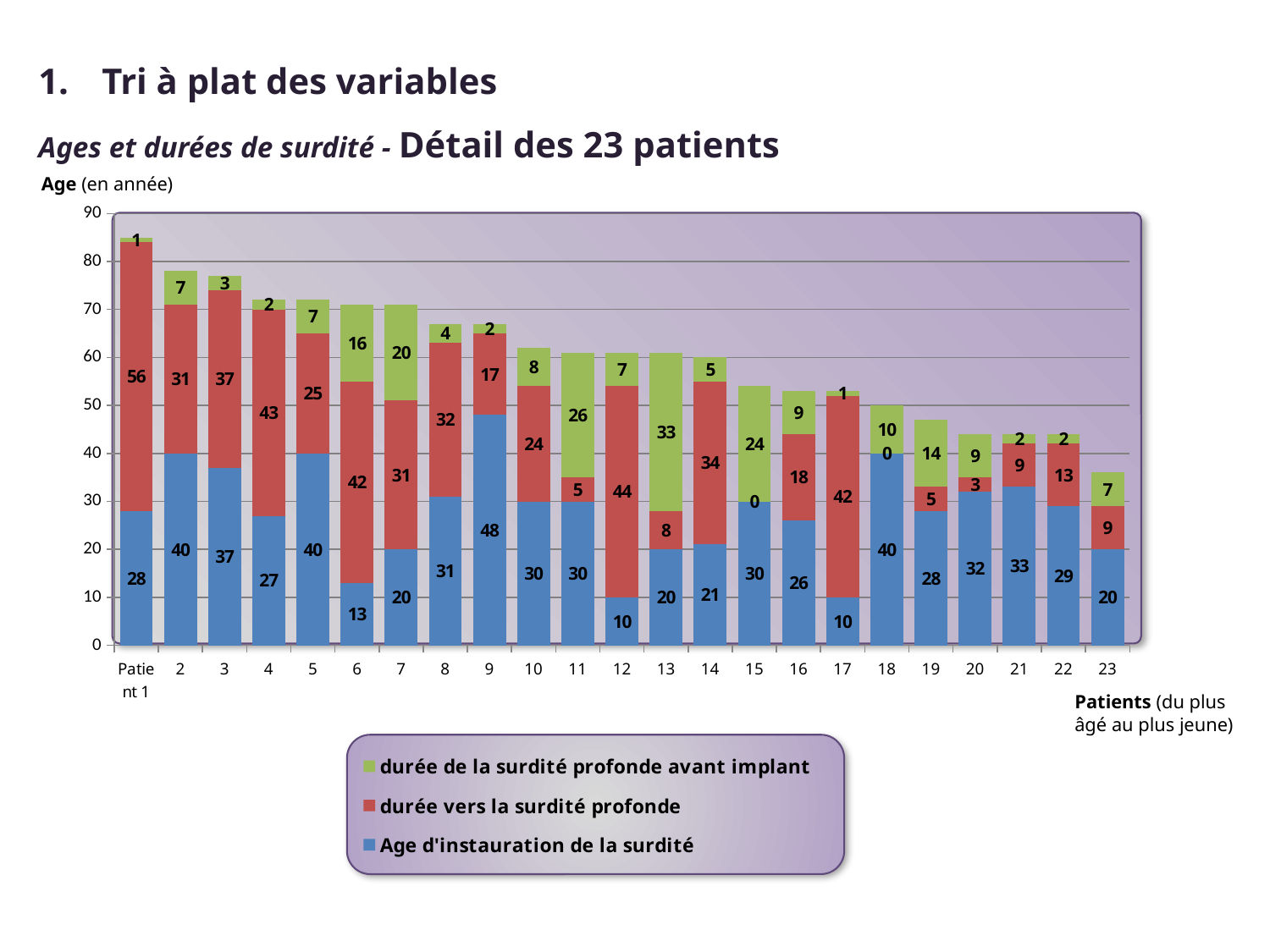
How many patients are shown on the x axis? 23 Which patient has the highest value for "Age d'instauration de la surdité"? 9 What is the value of "Age d'instauration de la surdité" for patient 9? 48 Which is larger: the "durée de la surdité profonde avant implant" for patient 6 or for patient 7? patient 7 How many series does the legend list? 3 What kind of chart is shown on the slide? stacked bar chart What is the total height of the stacked bar for patient 23? 36 What is the total height of the stacked bar for patient 1? 85 Which patient has the lowest value for "durée vers la surdité profonde" among those with a non-zero value? 20 What is the value of "durée vers la surdité profonde" for patient 1? 56 What is the difference between the "durée vers la surdité profonde" values for patient 12 and patient 13? 36 What is the value of "durée de la surdité profonde avant implant" for patient 13? 33